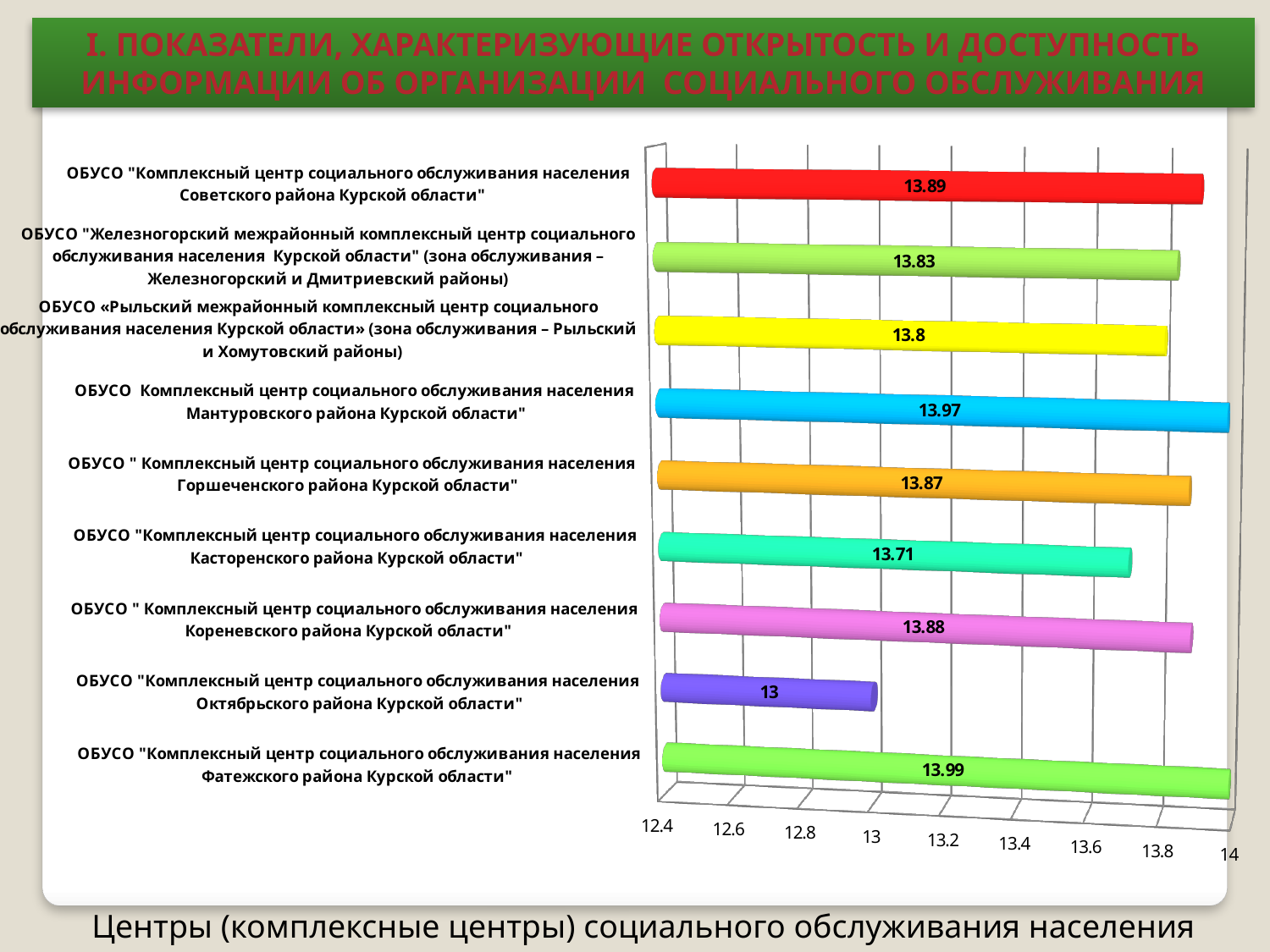
How many centres are shown in the chart? 9 Which has a larger value, the Железногорский межрайонный centre or the Рыльский межрайонный centre? Железногорский межрайонный centre What is the value for the Октябрьского района centre? 13 What is the value for the Мантуровского района centre? 13.97 What is the difference between the values for the Фатежского района centre and the Октябрьского района centre? 0.99 What is the value for the Горшеченского района centre? 13.87 Which centre has the highest value? ОБУСО "Комплексный центр социального обслуживания населения Фатежского района Курской области" What is the value for ОБУСО "Комплексный центр социального обслуживания населения Советского района Курской области"? 13.89 What kind of chart is shown on the slide? bar chart Which centre has the lowest value? ОБУСО "Комплексный центр социального обслуживания населения Октябрьского района Курской области" Is the value for the Кореневского района centre greater or less than 13.6? greater What is the value for the Касторенского района centre? 13.71